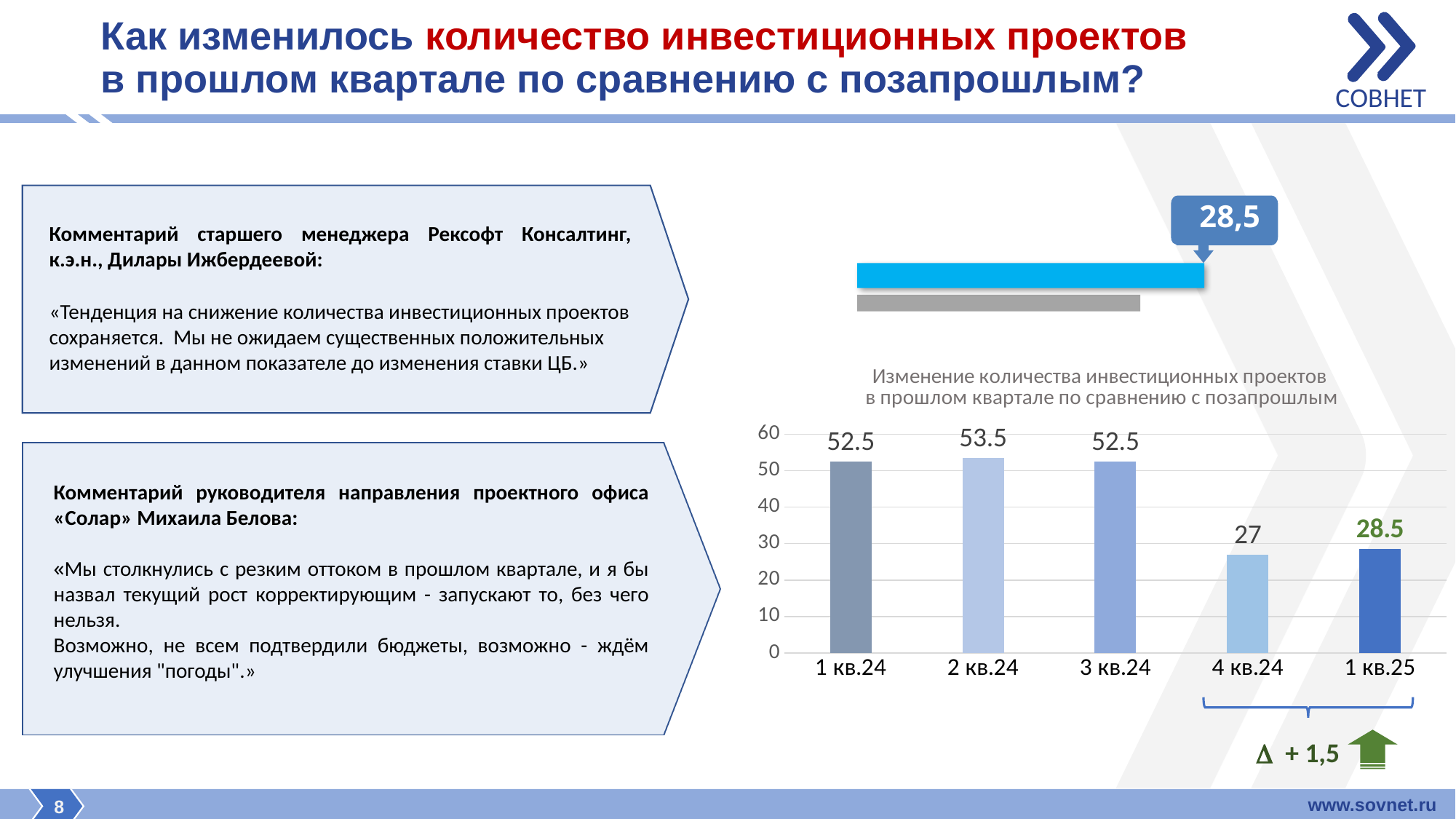
What kind of chart is shown on the slide? bar chart What is the difference between the values for 2 кв.24 and 1 кв.24? 1 Which is larger, the value for 3 кв.24 or the value for 4 кв.24? 3 кв.24 What is the difference between the values for 1 кв.25 and 4 кв.24? 1.5 What is the value for 4 кв.24 in the bar chart? 27 Is the value for 4 кв.24 greater or less than 30? less Which quarter has the highest value in the bar chart? 2 кв.24 How many quarters are shown on the x axis of the bar chart? 5 What is the value for 2 кв.24 in the bar chart? 53.5 What is the value for 1 кв.25 in the bar chart? 28.5 What is the title of the bar chart? Изменение количества инвестиционных проектов в прошлом квартале по сравнению с позапрошлым Which quarter has the lowest value in the bar chart? 4 кв.24